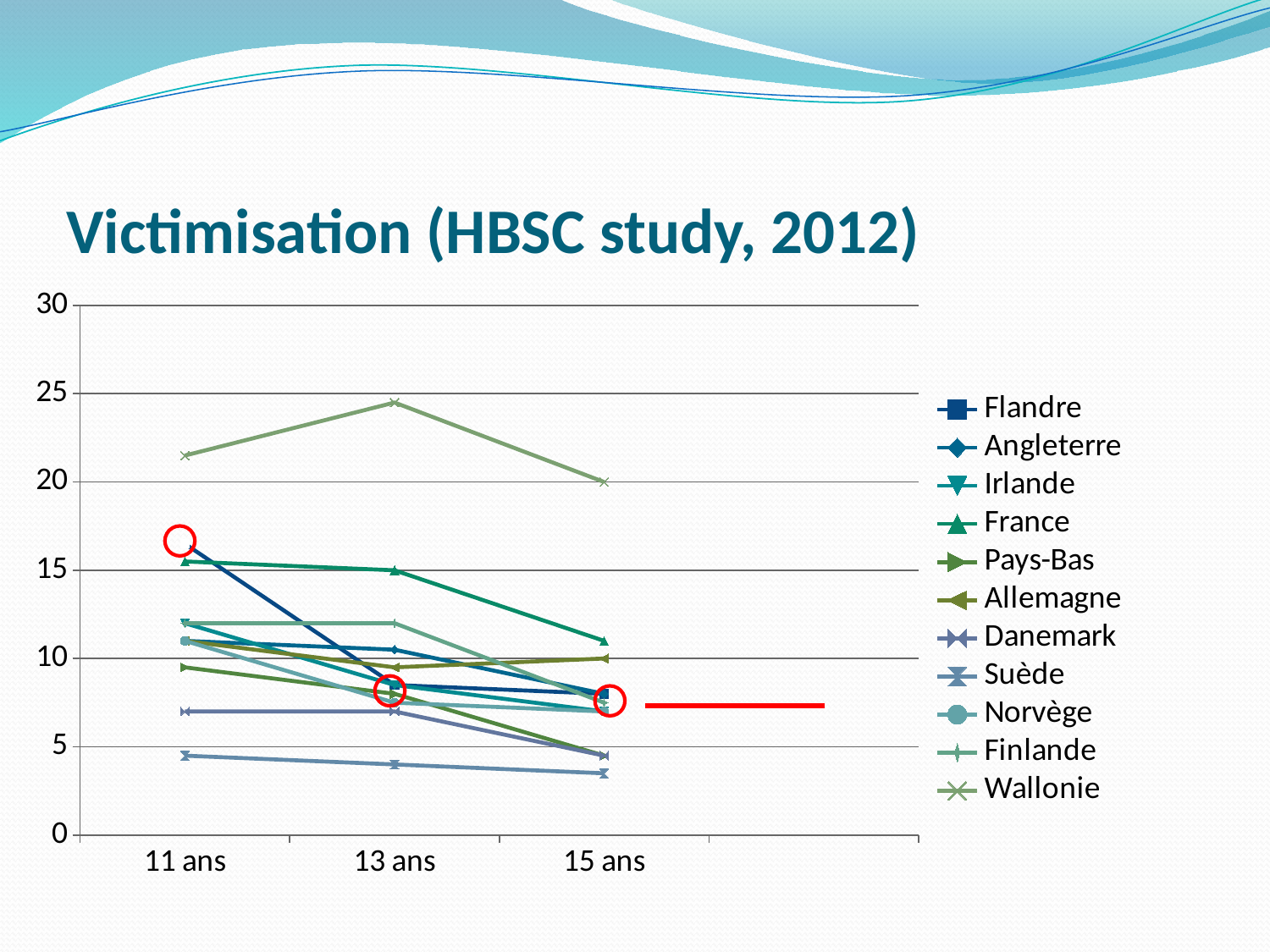
What is the value for France at 13 ans? 15 Is the value for Wallonie at 13 ans greater or less than 20? greater Is the value for Suède at 11 ans greater or less than 5? less What is the title of the chart? Victimisation (HBSC study, 2012) Does the value for Flandre rise or fall from 11 ans to 15 ans? fall What kind of chart is shown on the slide? line chart What is the value for Wallonie at 15 ans? 20 Which is larger at 11 ans, the value for Flandre or the value for France? Flandre Which series has the highest value at 13 ans? Wallonie Which series has the lowest value at 15 ans? Suède How many series does the legend list? 11 How many age categories are shown on the x axis? 3